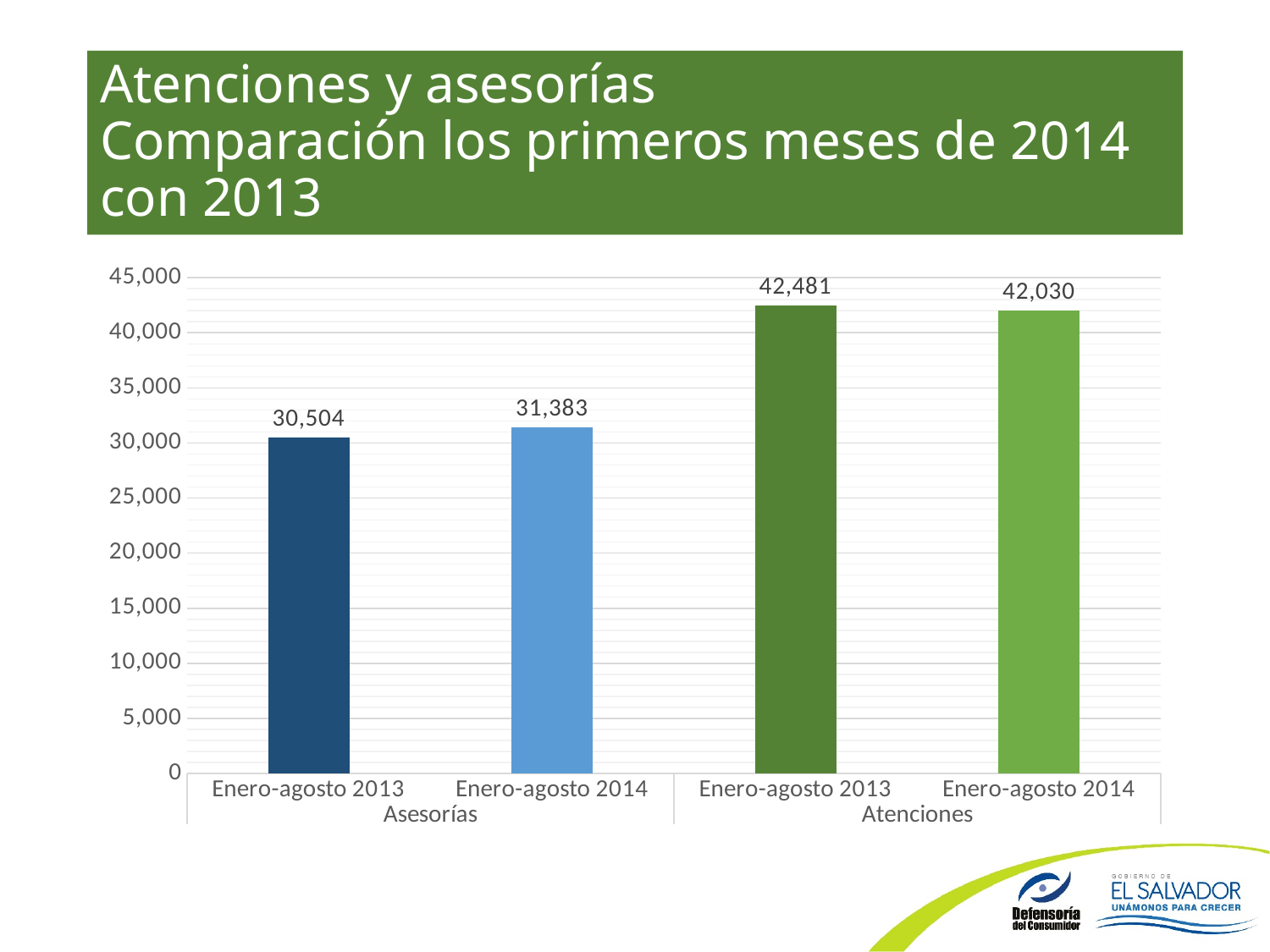
Which is larger: Asesorías in Enero-agosto 2014 or Atenciones in Enero-agosto 2014? Atenciones in Enero-agosto 2014 What is the difference between Atenciones in Enero-agosto 2013 and Enero-agosto 2014? 451 What is the highest value shown on the vertical axis? 45,000 Which bar has the lowest value? Asesorías, Enero-agosto 2013 What is the value for Asesorías in Enero-agosto 2014? 31,383 What is the value for Atenciones in Enero-agosto 2014? 42,030 What is the value for Atenciones in Enero-agosto 2013? 42,481 What is the difference between Asesorías in Enero-agosto 2014 and Enero-agosto 2013? 879 Which bar has the highest value? Atenciones, Enero-agosto 2013 What kind of chart is shown on the slide? Bar chart What is the value for Asesorías in Enero-agosto 2013? 30,504 How many bars are plotted in the chart? 4